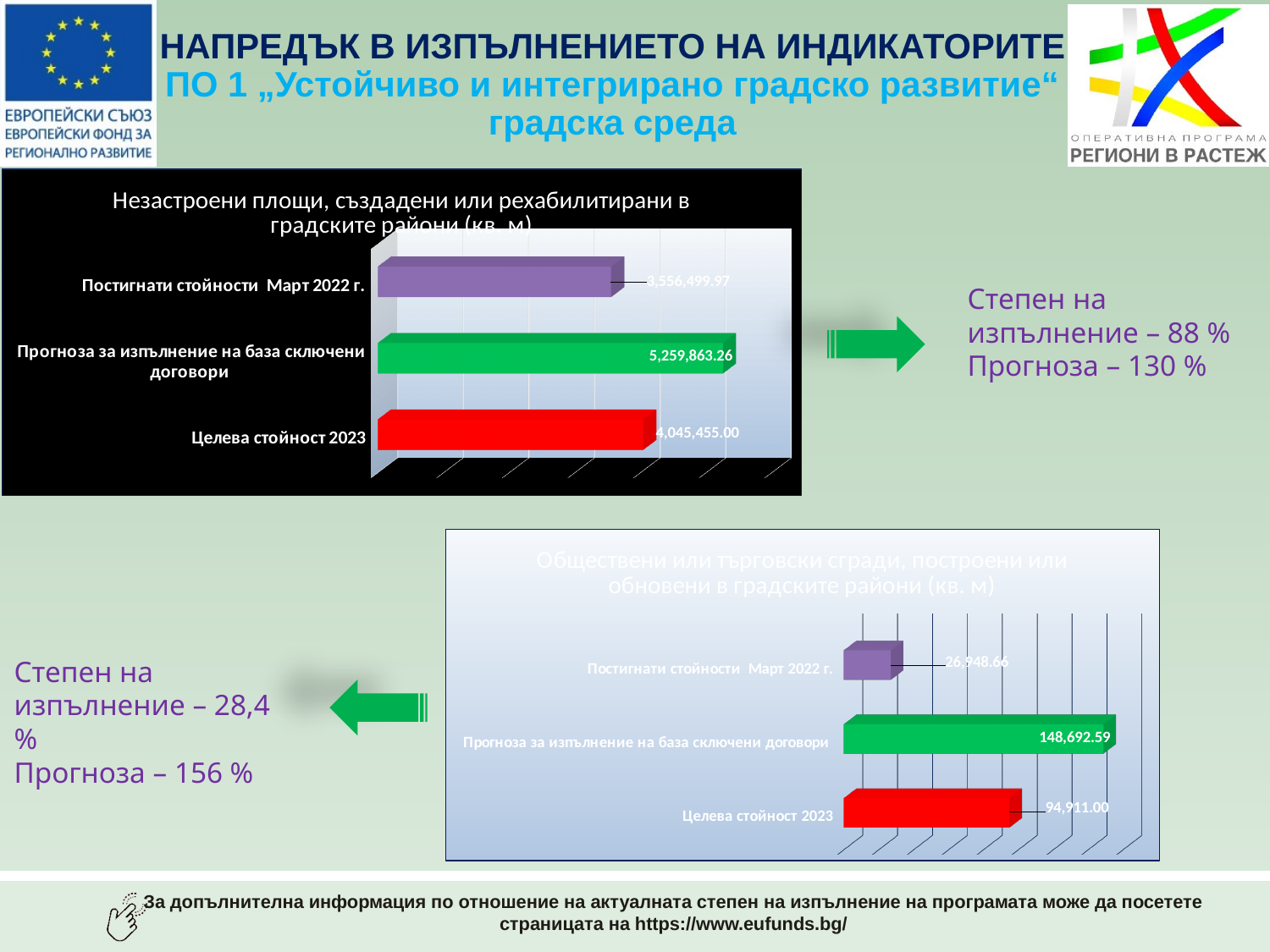
In the top chart 'Незастроени площи, създадени или рехабилитирани в градските райони (кв. м)', which is larger: 'Прогноза за изпълнение на база сключени договори' or 'Целева стойност 2023'? Прогноза за изпълнение на база сключени договори In the bottom chart, which category has the highest value? Прогноза за изпълнение на база сключени договори In the bottom chart, what is the difference between 'Прогноза за изпълнение на база сключени договори' and 'Целева стойност 2023'? 53,781.59 In the bottom chart, what is the value for 'Целева стойност 2023'? 94,911.00 What type of chart is the top chart 'Незастроени площи, създадени или рехабилитирани в градските райони (кв. м)'? Bar chart In the top chart 'Незастроени площи, създадени или рехабилитирани в градските райони (кв. м)', which category has the highest value? Прогноза за изпълнение на база сключени договори In the top chart 'Незастроени площи, създадени или рехабилитирани в градските райони (кв. м)', what is the value for 'Целева стойност 2023'? 4,045,455.00 In the top chart 'Незастроени площи, създадени или рехабилитирани в градските райони (кв. м)', what is the difference between 'Прогноза за изпълнение на база сключени договори' and 'Целева стойност 2023'? 1,214,408.26 In the top chart 'Незастроени площи, създадени или рехабилитирани в градските райони (кв. м)', what is the value for 'Прогноза за изпълнение на база сключени договори'? 5,259,863.26 In the top chart 'Незастроени площи, създадени или рехабилитирани в градските райони (кв. м)', which category has the lowest value? Постигнати стойности Март 2022 г. In the bottom chart, what is the value for 'Прогноза за изпълнение на база сключени договори'? 148,692.59 In the top chart 'Незастроени площи, създадени или рехабилитирани в градските райони (кв. м)', how many categories are plotted? 3